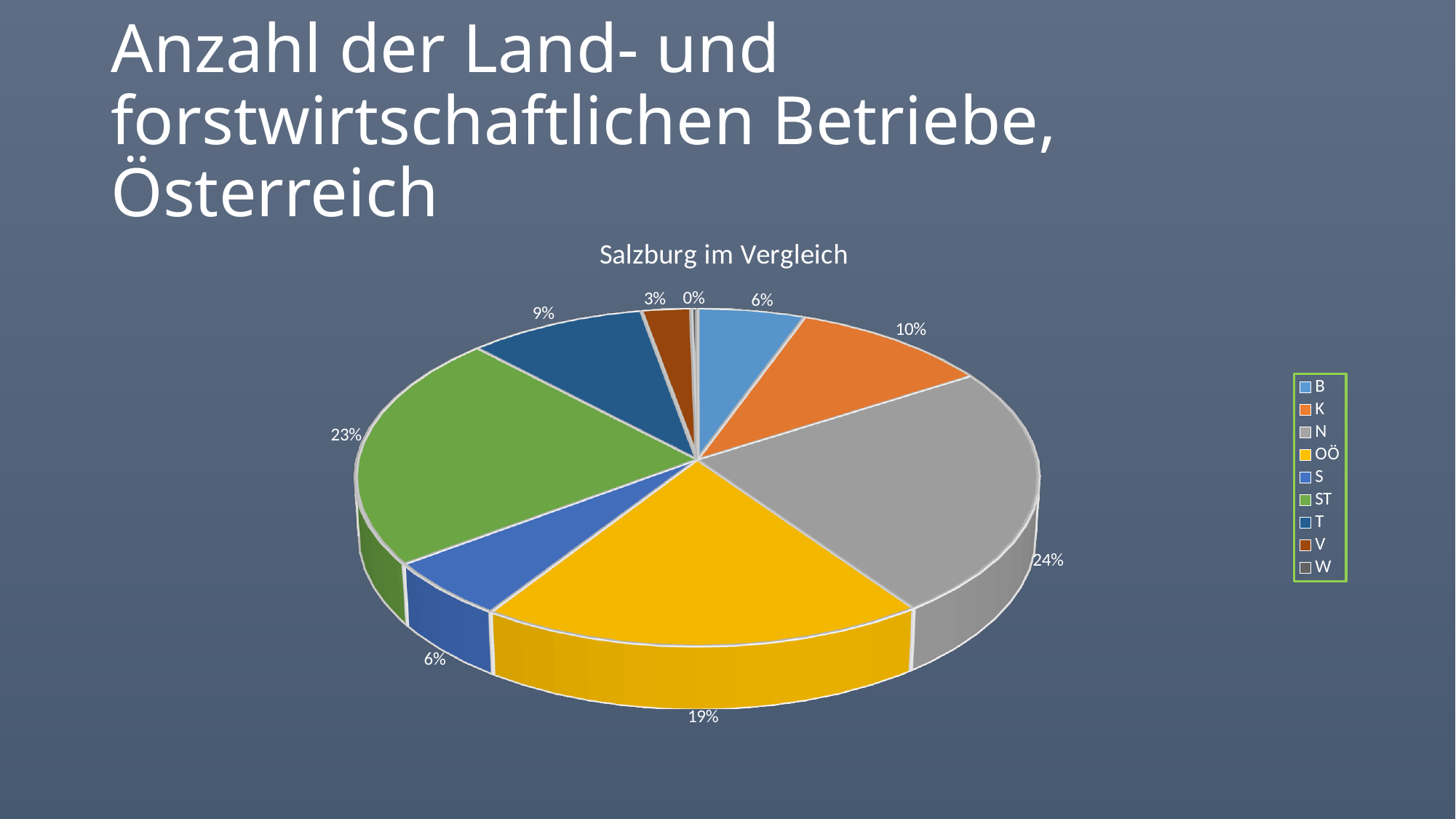
Which has a larger share, K or T? K How many categories does the legend of the pie chart list? 9 What kind of chart is shown on the slide? pie chart What is the title of the chart? Salzburg im Vergleich What is the difference in percentage points between the shares of N and OÖ? 5 What share of the pie does OÖ have? 19% What share of the pie does ST have? 23% Which category has the smallest share of the pie? W What share of the pie does V have? 3% Which category has the largest share of the pie? N